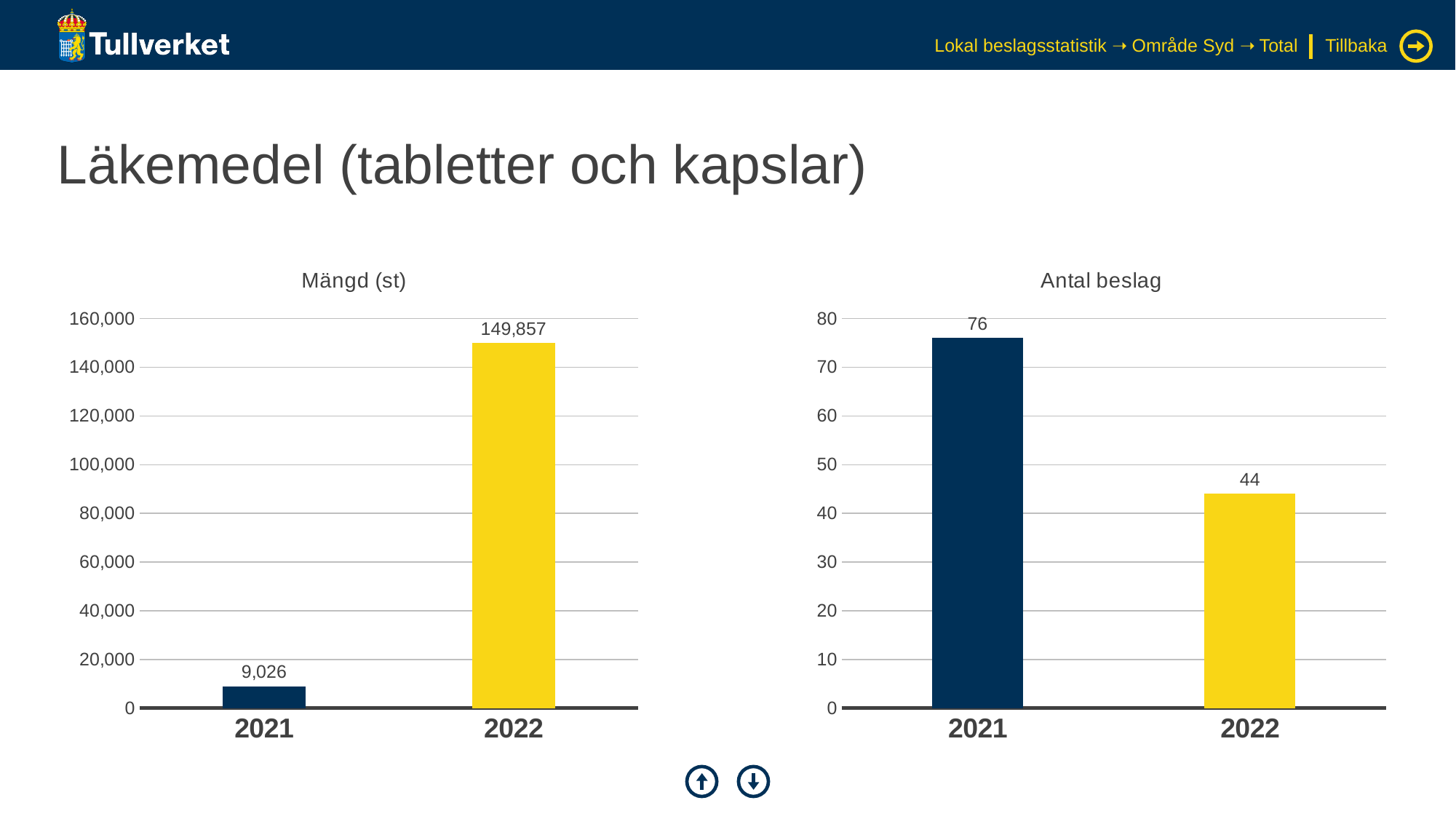
In the 'Mängd (st)' chart, which year has the highest value? 2022 In the 'Antal beslag' chart, do the values rise or fall from 2021 to 2022? fall In the 'Antal beslag' chart, what is the difference between the values for 2021 and 2022? 32 In the 'Antal beslag' chart, what is the value for 2021? 76 In the 'Mängd (st)' chart, how many years are shown on the x axis? 2 In the 'Mängd (st)' chart, what is the value for 2021? 9,026 In the 'Antal beslag' chart, which year has the lowest value? 2022 What kind of chart is the 'Antal beslag' chart? bar chart In the 'Mängd (st)' chart, what is the value for 2022? 149,857 In the 'Antal beslag' chart, is the value for 2021 greater or less than 70? greater In the 'Mängd (st)' chart, what is the difference between the values for 2022 and 2021? 140,831 In the 'Antal beslag' chart, what is the value for 2022? 44